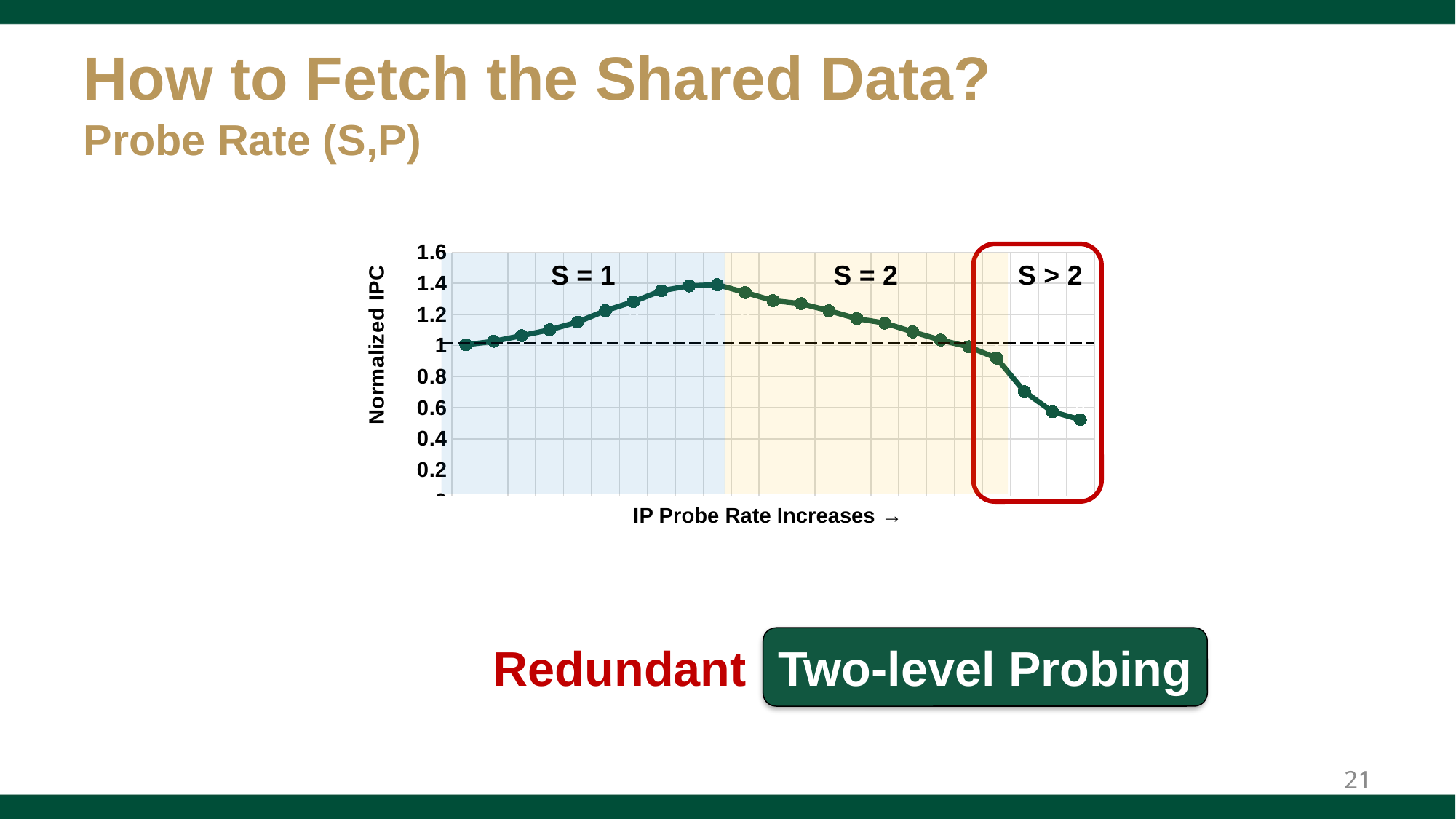
Is the highest Normalized IPC value on the chart greater or less than 1.2? greater Is the last (rightmost) Normalized IPC value on the chart greater or less than 0.6? less What is the label of the y axis of the chart? Normalized IPC Which is larger, the Normalized IPC at the peak of the S = 1 region or the Normalized IPC at the end of the S > 2 region? the peak of the S = 1 region Which labelled region contains the lowest Normalized IPC values? S > 2 Is the Normalized IPC at the end of the S = 2 region greater or less than 1.2? less In the S = 1 region, do the Normalized IPC values rise or fall as the IP probe rate increases? rise In the S > 2 region, do the Normalized IPC values rise or fall as the IP probe rate increases? fall Which region of the chart is outlined with a red box? S > 2 In the S = 2 region, do the Normalized IPC values rise or fall as the IP probe rate increases? fall What kind of chart is shown on the slide? line chart